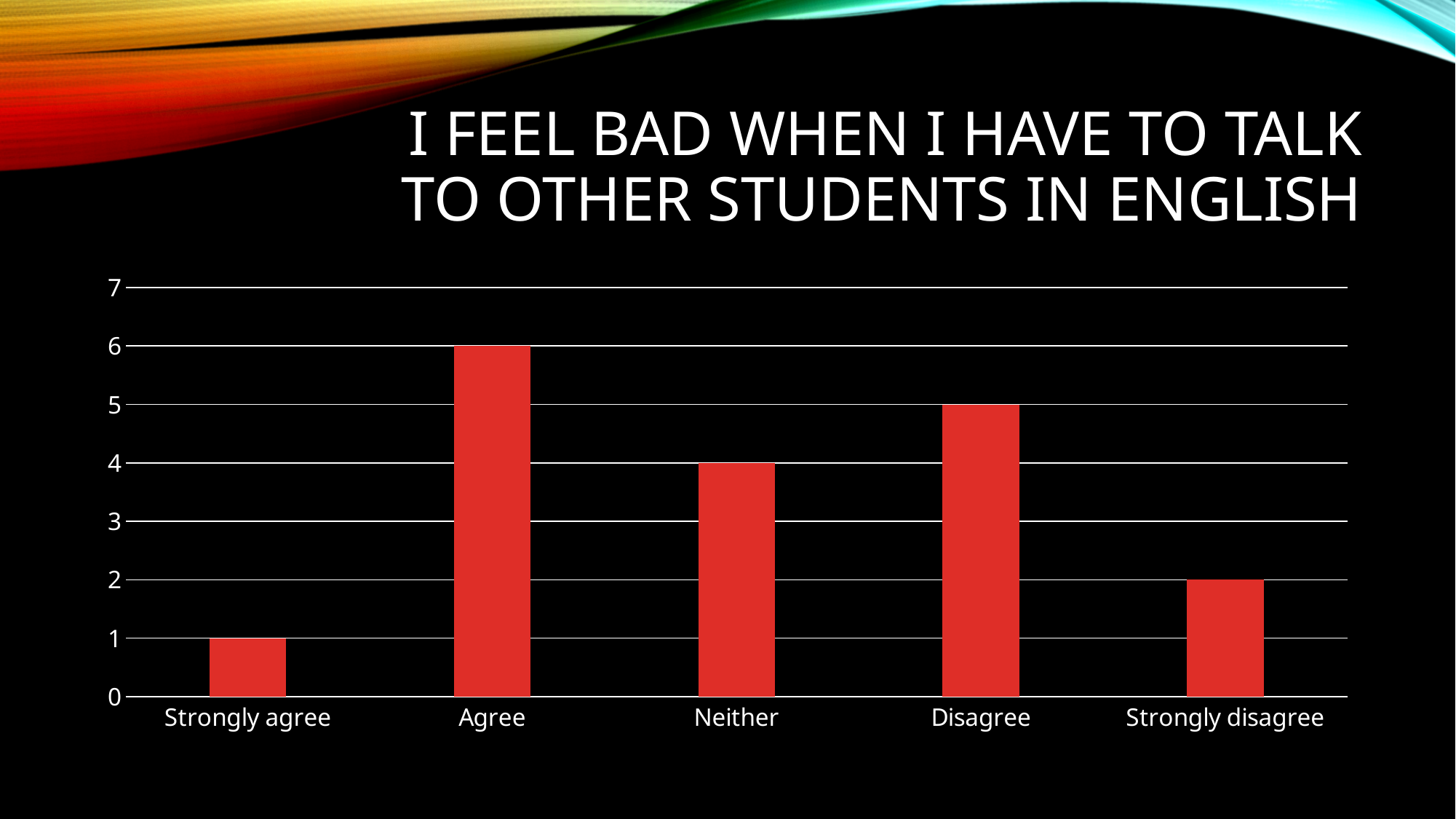
Which is larger, the value for Disagree or the value for Strongly disagree? Disagree Is the value for Neither greater or less than 3? greater How many categories are shown on the x axis? 5 What is the value for Agree? 6 What colour are the bars in the chart? red What is the value for Strongly agree? 1 What is the title of the slide? I feel bad when I have to talk to other students in English Which category has the highest value? Agree Which category has the lowest value? Strongly agree What kind of chart is shown on the slide? bar chart What is the difference between the values for Agree and Neither? 2 What is the value for Disagree? 5